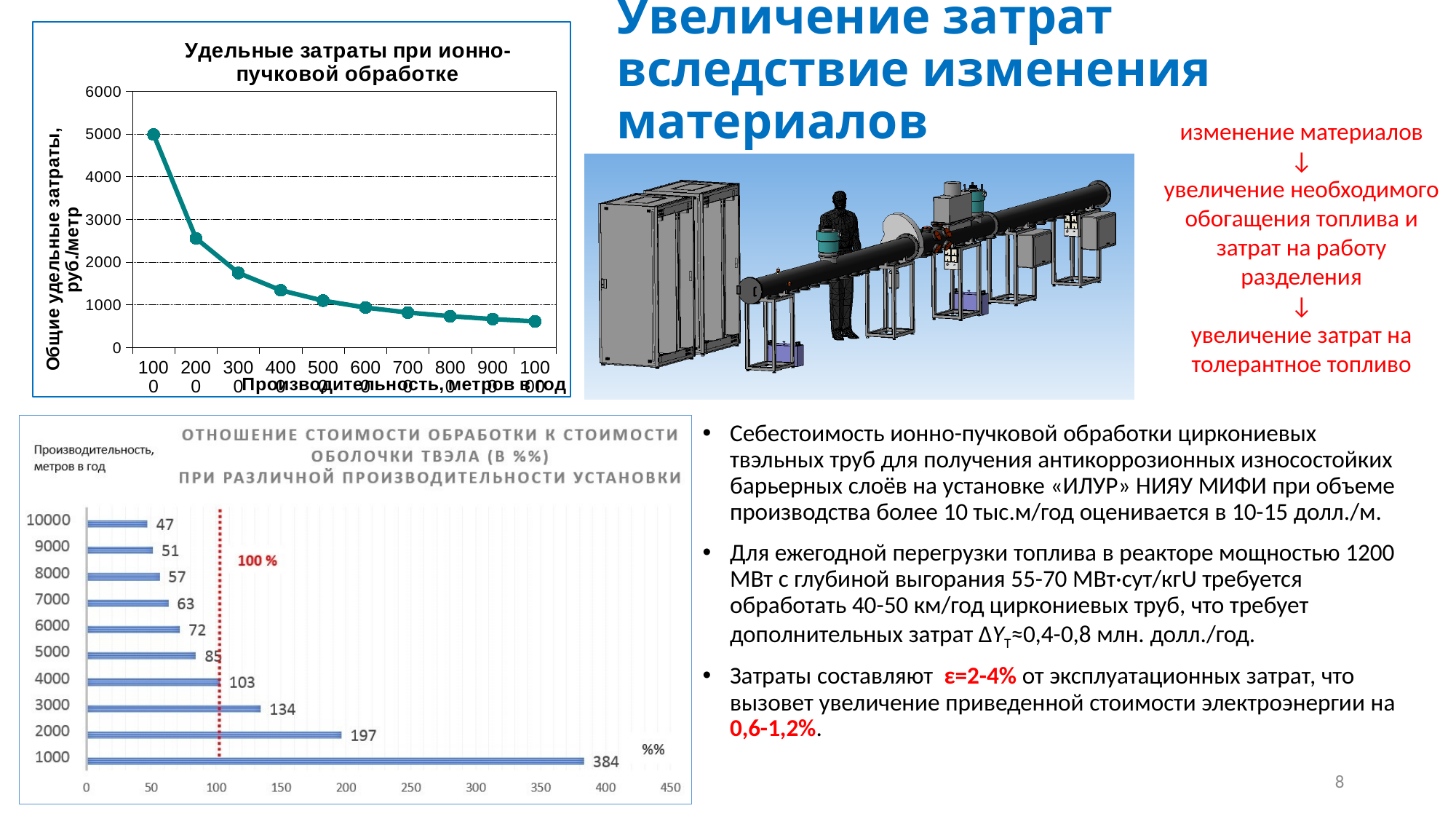
In the bar chart 'Отношение стоимости обработки к стоимости оболочки твэла', what is the difference between the values for 2000 and 3000 metres per year? 63 In the bar chart 'Отношение стоимости обработки к стоимости оболочки твэла', which productivity category has the highest value? 1000 In the bar chart 'Отношение стоимости обработки к стоимости оболочки твэла', what is the value for a productivity of 5000 metres per year? 85 In the bar chart 'Отношение стоимости обработки к стоимости оболочки твэла', what is the value for a productivity of 1000 metres per year? 384 In the bar chart 'Отношение стоимости обработки к стоимости оболочки твэла', which productivity category has the lowest value? 10000 What kind of chart is the bottom-left chart 'Отношение стоимости обработки к стоимости оболочки твэла'? bar chart In the bar chart 'Отношение стоимости обработки к стоимости оболочки твэла', which is larger: the value for 4000 or the value for 6000 metres per year? 4000 In the line chart 'Удельные затраты при ионно-пучковой обработке', do the values rise or fall as productivity increases along the x axis? fall What kind of chart is the top-left chart 'Удельные затраты при ионно-пучковой обработке'? line chart In the bar chart 'Отношение стоимости обработки к стоимости оболочки твэла', what is the value for a productivity of 10000 metres per year? 47 How many productivity categories are shown in the bar chart 'Отношение стоимости обработки к стоимости оболочки твэла'? 10 In the line chart 'Удельные затраты при ионно-пучковой обработке', is the value at the last (rightmost) point greater or less than 1000? less